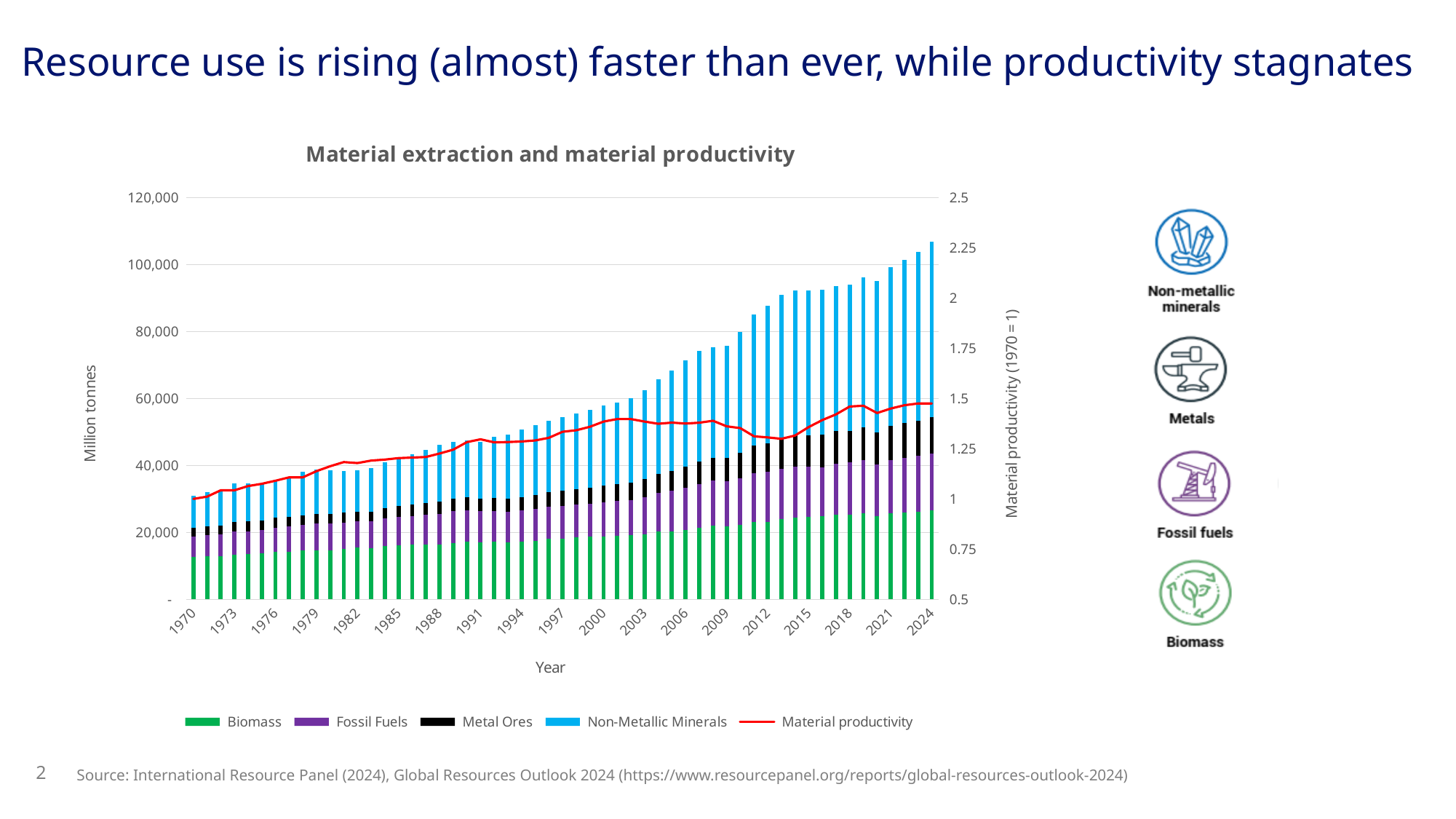
Which year has the shortest stacked bar (lowest total material extraction)? 1970 Which year has the tallest stacked bar (highest total material extraction)? 2024 What kind of chart is shown on the slide? bar chart with a line Is the Material productivity value for 2024 greater or less than 1.25? greater Which series is drawn as a red line rather than as bars? Material productivity Does total material extraction rise or fall from 1970 to 2024? rise How many year labels are shown on the x axis? 19 What is the title of the chart? Material extraction and material productivity How many series does the legend list? 5 Is the total material extraction for 2024 greater or less than 100,000 million tonnes? greater Is the total material extraction for 1970 greater or less than 40,000 million tonnes? less Which year has the larger total material extraction, 2000 or 2012? 2012